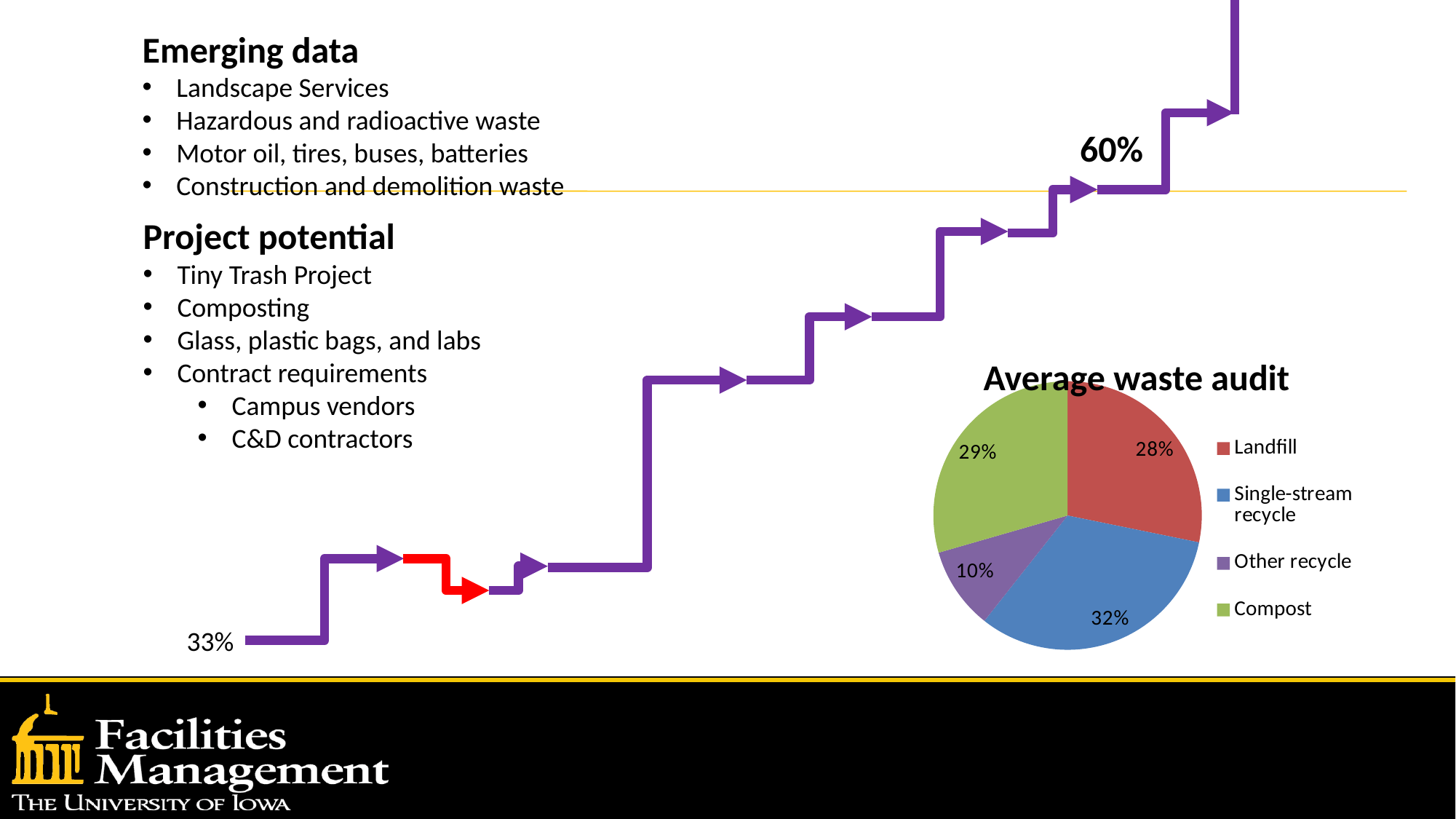
In the 'Average waste audit' chart, what share is Landfill? 28% In the 'Average waste audit' chart, what colour is the Compost slice? Green In the 'Average waste audit' chart, which category has the smallest slice? Other recycle In the 'Average waste audit' chart, which category has the largest slice? Single-stream recycle In the 'Average waste audit' chart, which is larger, Compost or Other recycle? Compost In the 'Average waste audit' chart, what share is Other recycle? 10% What kind of chart is 'Average waste audit'? Pie chart In the 'Average waste audit' chart, what share is Compost? 29% How many categories does the 'Average waste audit' chart show? 4 In the 'Average waste audit' chart, what share is Single-stream recycle? 32% In the 'Average waste audit' chart, what is the combined share of Single-stream recycle and Other recycle? 42% In the 'Average waste audit' chart, what is the difference between the Single-stream recycle and Landfill shares? 4%